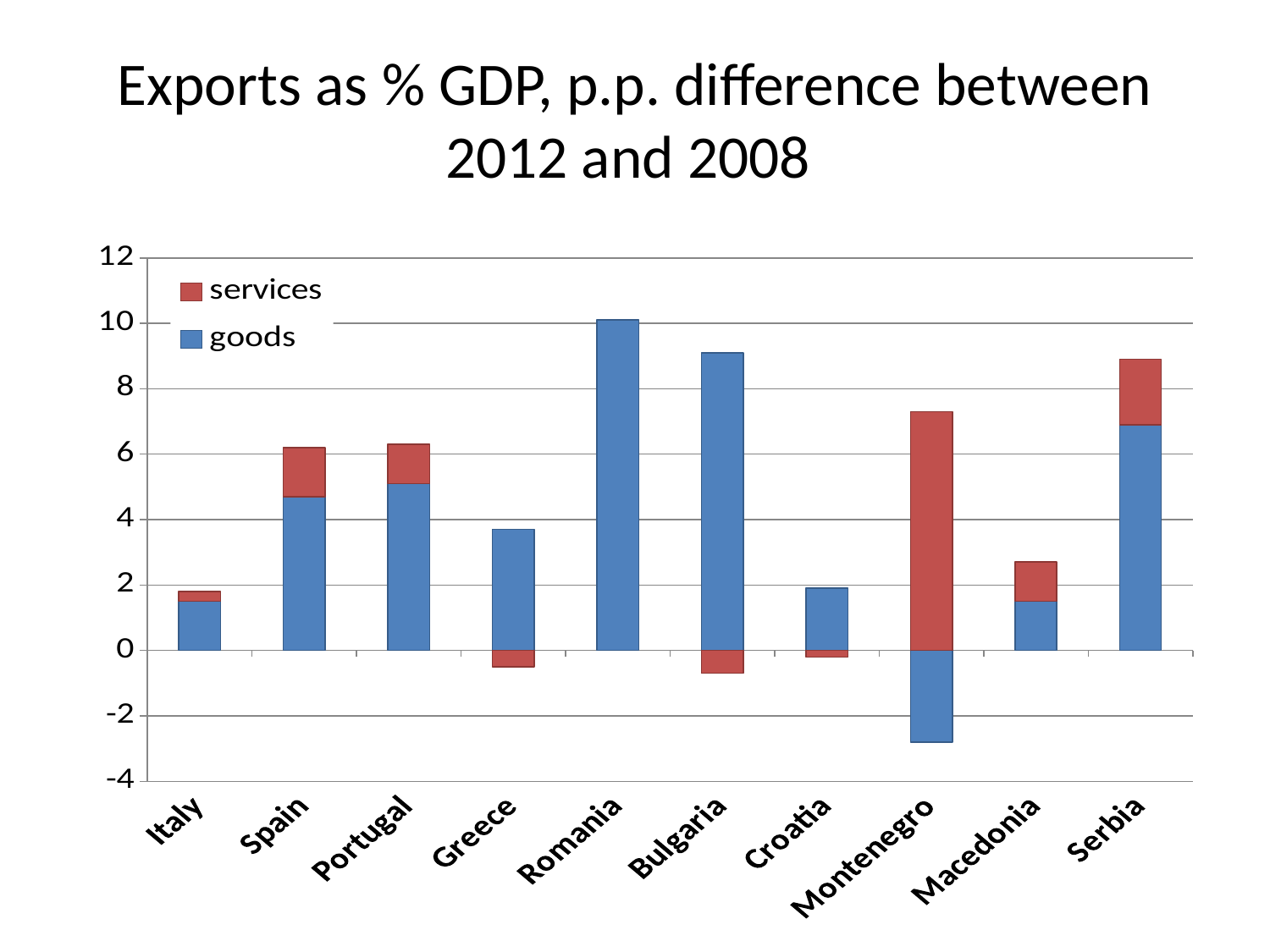
Is the goods value for Greece greater or less than 2? greater Is the goods value for Romania greater or less than 8? greater Which country has the lowest value for goods? Montenegro Which colour represents the services series in the chart? red Which country has the highest value for goods? Romania Is the services value for Montenegro greater or less than 6? greater Which is larger, the goods value for Romania or the goods value for Bulgaria? Romania How many series does the chart's legend list? 2 Which country has the highest value for services? Montenegro How many countries are shown on the x axis of the chart? 10 What kind of chart is shown on the slide? bar chart